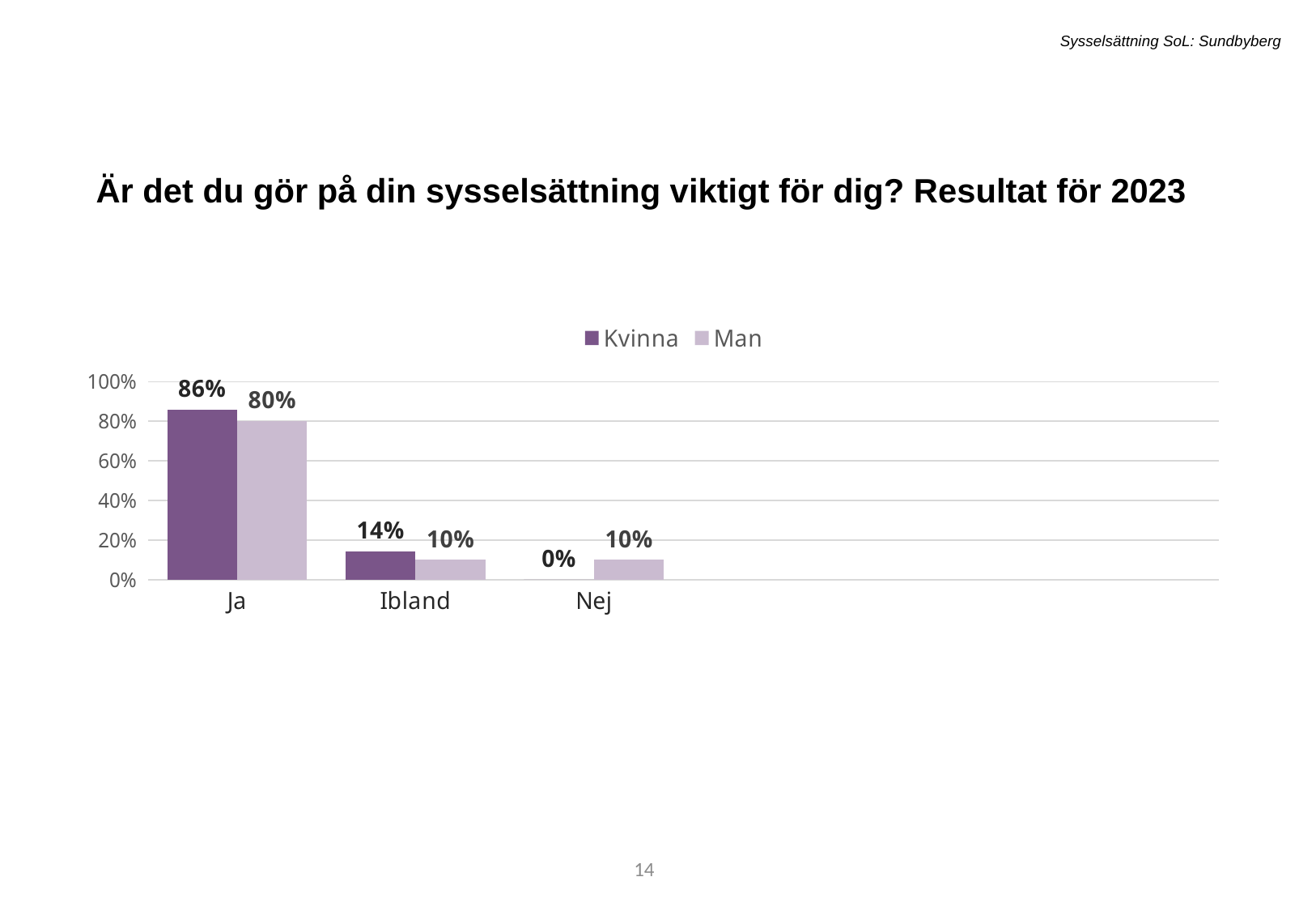
What is the value for Kvinna in the Ja category? 86% Which category has the lowest value for the Kvinna series? Nej What is the value for Kvinna in the Ibland category? 14% In the Ibland category, which series has the larger value, Kvinna or Man? Kvinna How many categories are shown on the x axis? 3 What is the difference between the Kvinna and Man values in the Ja category? 6% What is the value for Man in the Ja category? 80% How many series does the legend list? 2 What is the value for Kvinna in the Nej category? 0% Which category has the highest value for the Man series? Ja What is the value for Man in the Nej category? 10% What kind of chart is shown on the slide? Bar chart